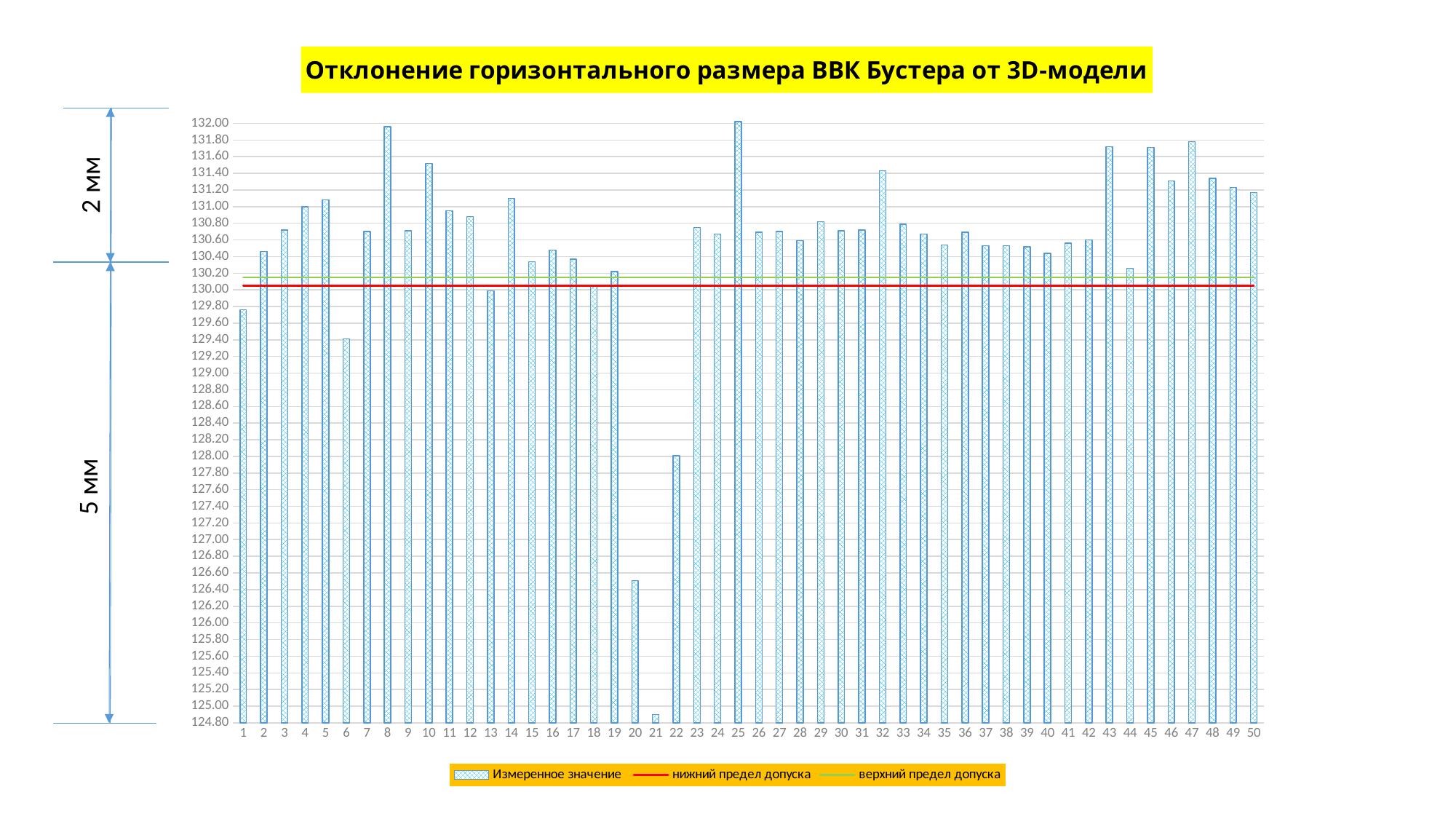
Is the measured value for measurement 8 greater or less than 131.00? greater What is the title of the chart? Отклонение горизонтального размера ВВК Бустера от 3D-модели Which legend entry is drawn as a red line? нижний предел допуска What kind of chart is shown on the slide? bar chart Is the measured value for measurement 6 greater or less than 130.00? less Which has the larger measured value, measurement 6 or measurement 7? 7 Is the measured value for measurement 20 greater or less than 126.00? greater How many entries does the legend list? 3 Which has the larger measured value, measurement 20 or measurement 22? 22 Which measurement number has the lowest measured value? 21 How many categories (measurement numbers) are shown on the x axis? 50